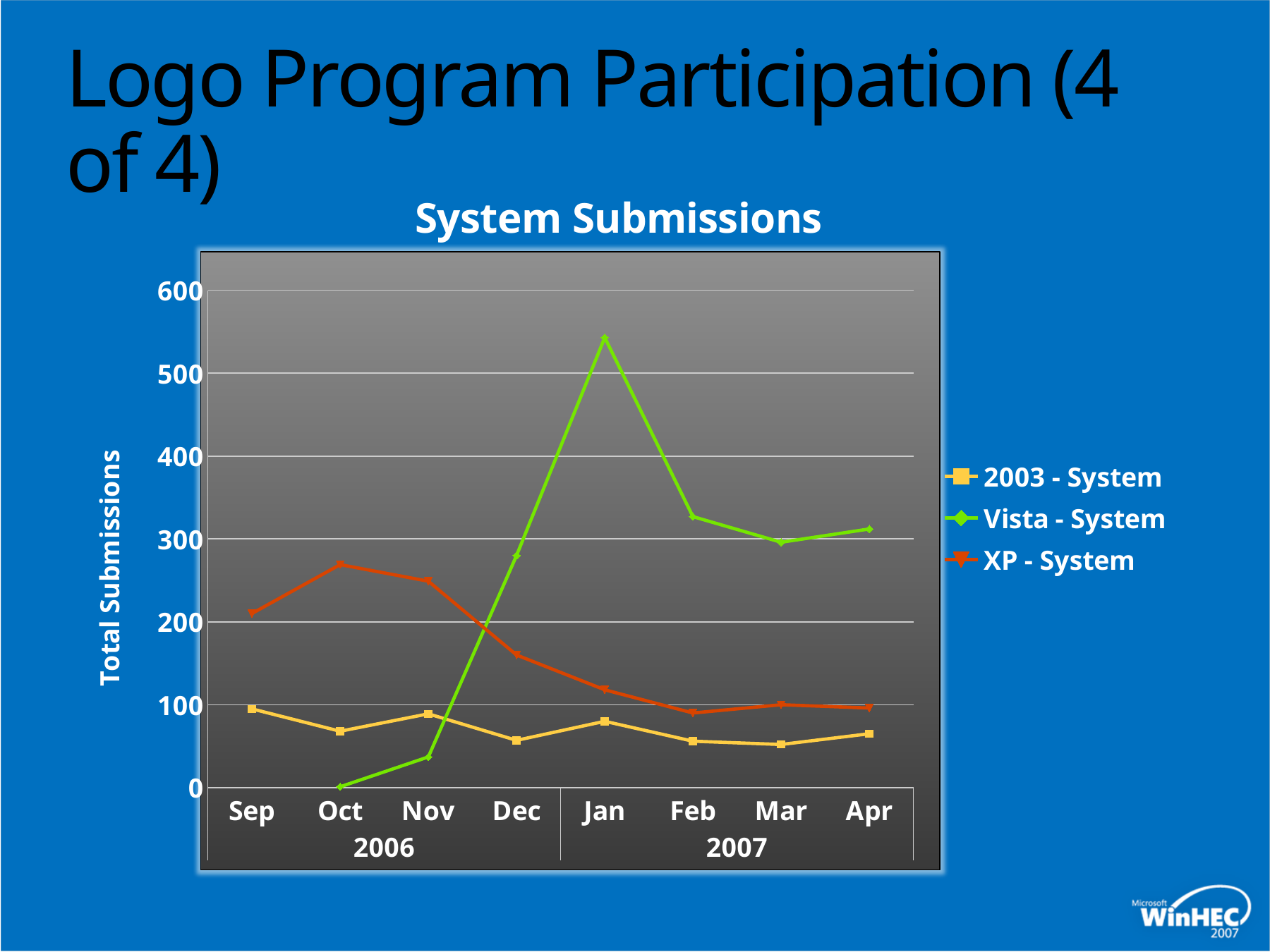
How many series does the legend list? 3 Is the value for XP - System in Oct greater or less than 200? greater How many months are shown along the x axis? 8 In which month does the Vista - System series reach its highest value? Jan Is the value for 2003 - System in Oct greater or less than 100? less What is the title of the chart? System Submissions In which month does the XP - System series reach its highest value? Oct What is the label on the vertical axis? Total Submissions Does the XP - System series rise or fall from Oct to Feb? fall In Jan, which series has the larger value, Vista - System or XP - System? Vista - System What kind of chart is shown on the slide? line chart Is the value for Vista - System in Jan greater or less than 500? greater